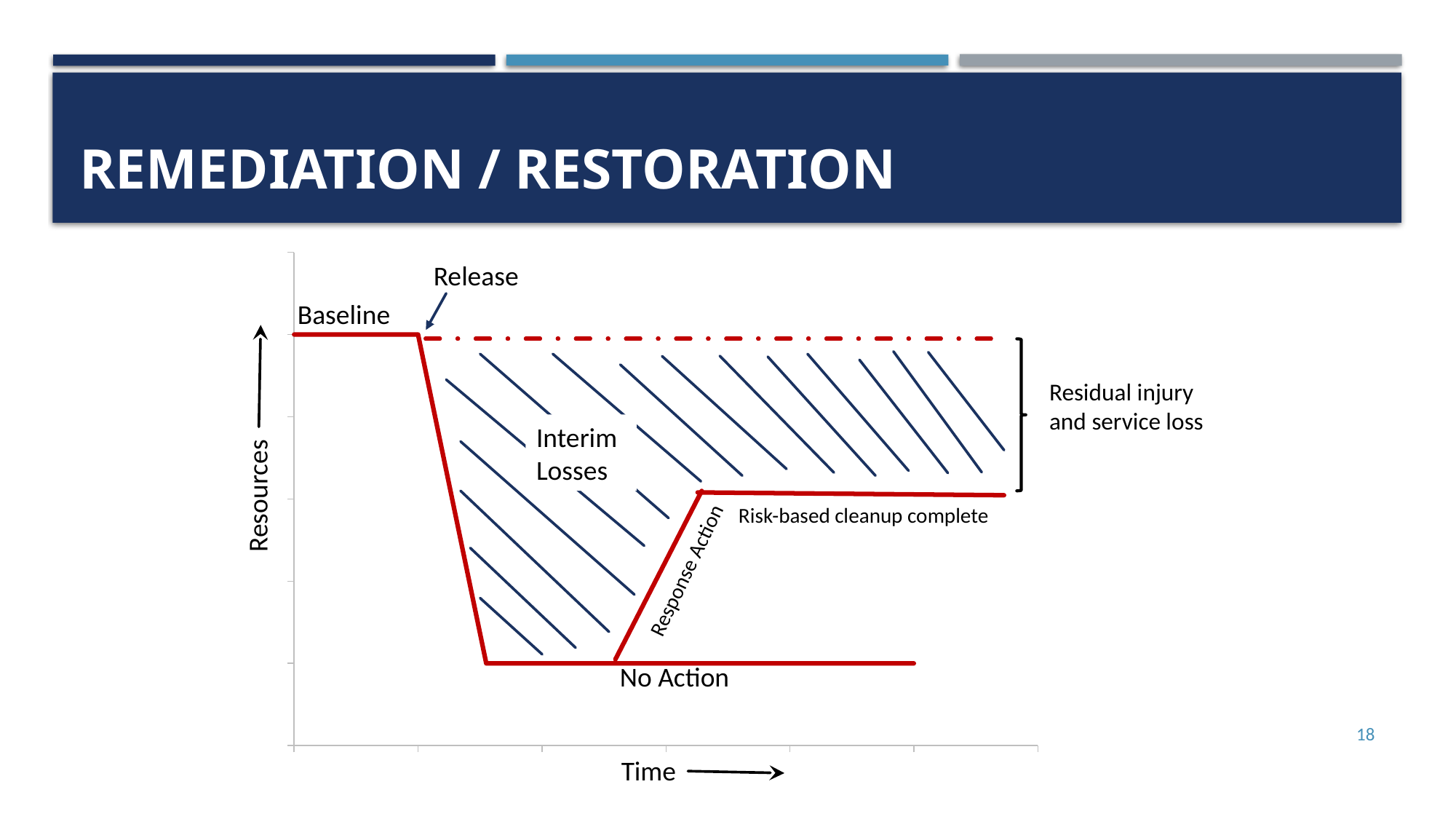
Along the segment labelled Response Action, do resources rise or fall over time? Rise What is the label on the vertical axis of the chart? Resources Which labelled level on the chart is the highest on the Resources axis? Baseline Which labelled level on the chart is the lowest on the Resources axis? No Action Which is higher on the Resources axis: the Baseline level or the level at Risk-based cleanup complete? Baseline What is the label on the horizontal axis of the chart? Time Which is higher on the Resources axis: the level at Risk-based cleanup complete or the No Action level? Risk-based cleanup complete What does the bracket on the right side of the chart, between the Baseline and the Risk-based cleanup complete level, represent? Residual injury and service loss Along the line labelled No Action, do resources rise, fall or stay flat over time? Stay flat What does the hatched area between the Baseline dashed line and the red line represent? Interim Losses What kind of chart is shown on the slide? Line chart Immediately after the point labelled Release, do resources rise or fall over time? Fall